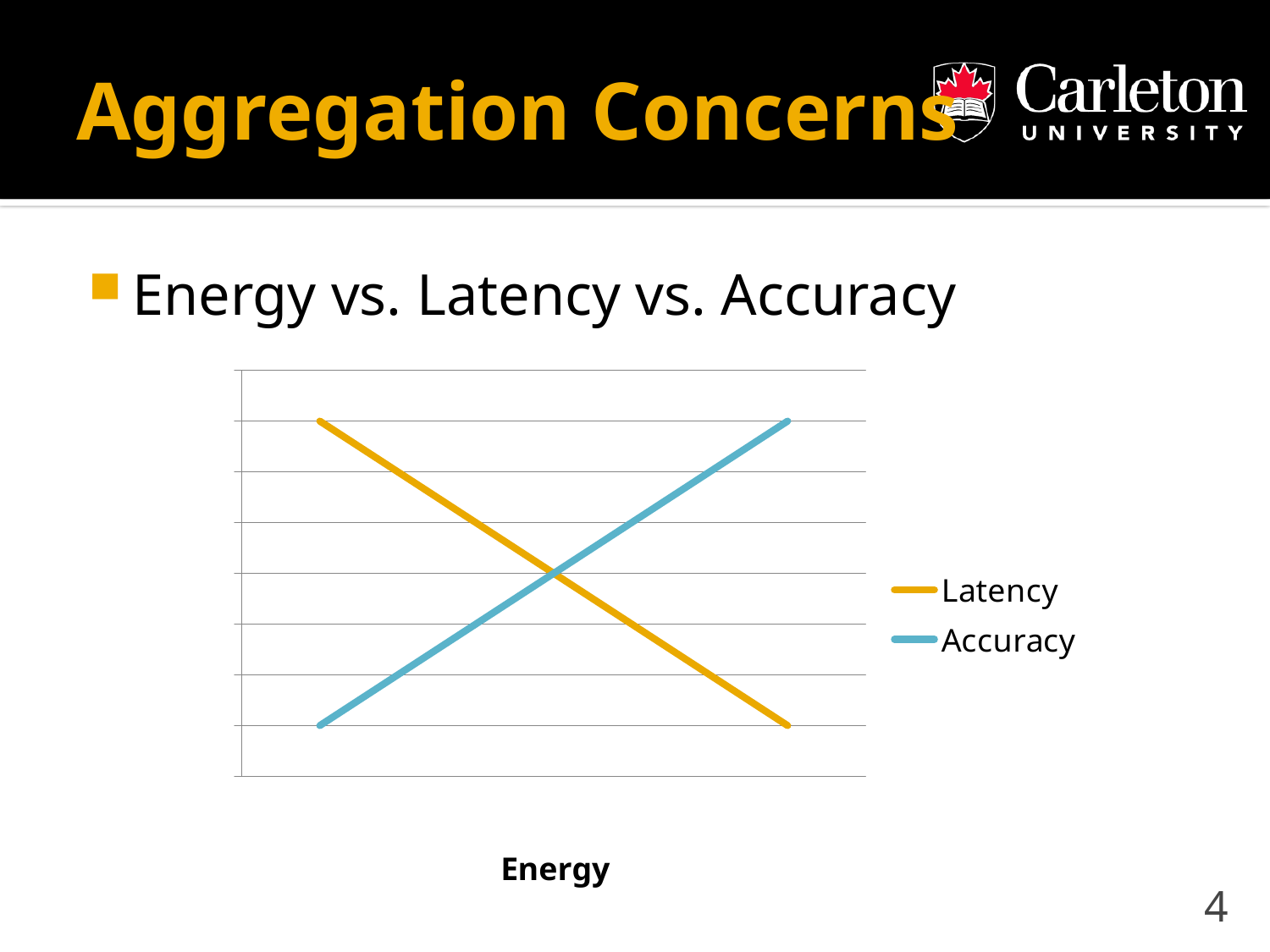
At the left end of the chart, which series has the higher value, Latency or Accuracy? Latency Which series is plotted in gold/yellow? Latency At the right end of the chart, which series has the higher value, Latency or Accuracy? Accuracy What is the label on the x axis of the chart? Energy Does the Latency line rise or fall as Energy increases along the x axis? fall What kind of chart is shown on the slide? line chart Does the Accuracy line rise or fall as Energy increases along the x axis? rise How many series does the legend list? 2